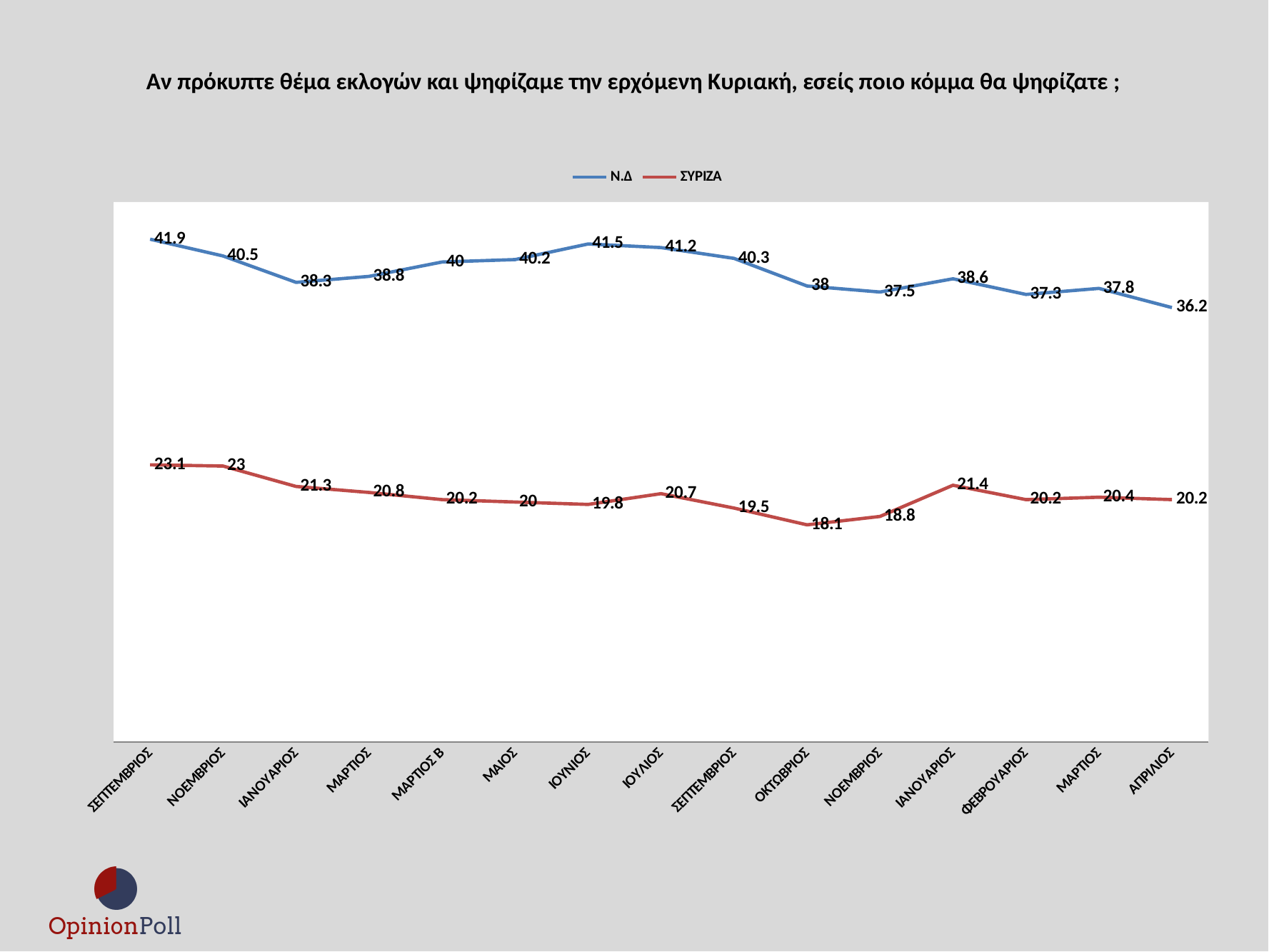
What is the difference between the Ν.Δ and ΣΥΡΙΖΑ values at ΑΠΡΙΛΙΟΣ? 16 What type of chart is shown on the slide? line chart What is the value for Ν.Δ at ΑΠΡΙΛΙΟΣ? 36.2 How many points are plotted along the x axis for each series? 15 Which series has the higher value at ΜΑΙΟΣ, Ν.Δ or ΣΥΡΙΖΑ? Ν.Δ What is the value for ΣΥΡΙΖΑ at ΦΕΒΡΟΥΑΡΙΟΣ? 20.2 What is the highest value plotted for Ν.Δ? 41.9 At which point on the x axis does ΣΥΡΙΖΑ reach its lowest value? ΟΚΤΩΒΡΙΟΣ At which point on the x axis does Ν.Δ reach its lowest value? ΑΠΡΙΛΙΟΣ How many series does the legend list? 2 What is the value for ΣΥΡΙΖΑ at ΟΚΤΩΒΡΙΟΣ? 18.1 What is the value for Ν.Δ at ΙΟΥΝΙΟΣ? 41.5